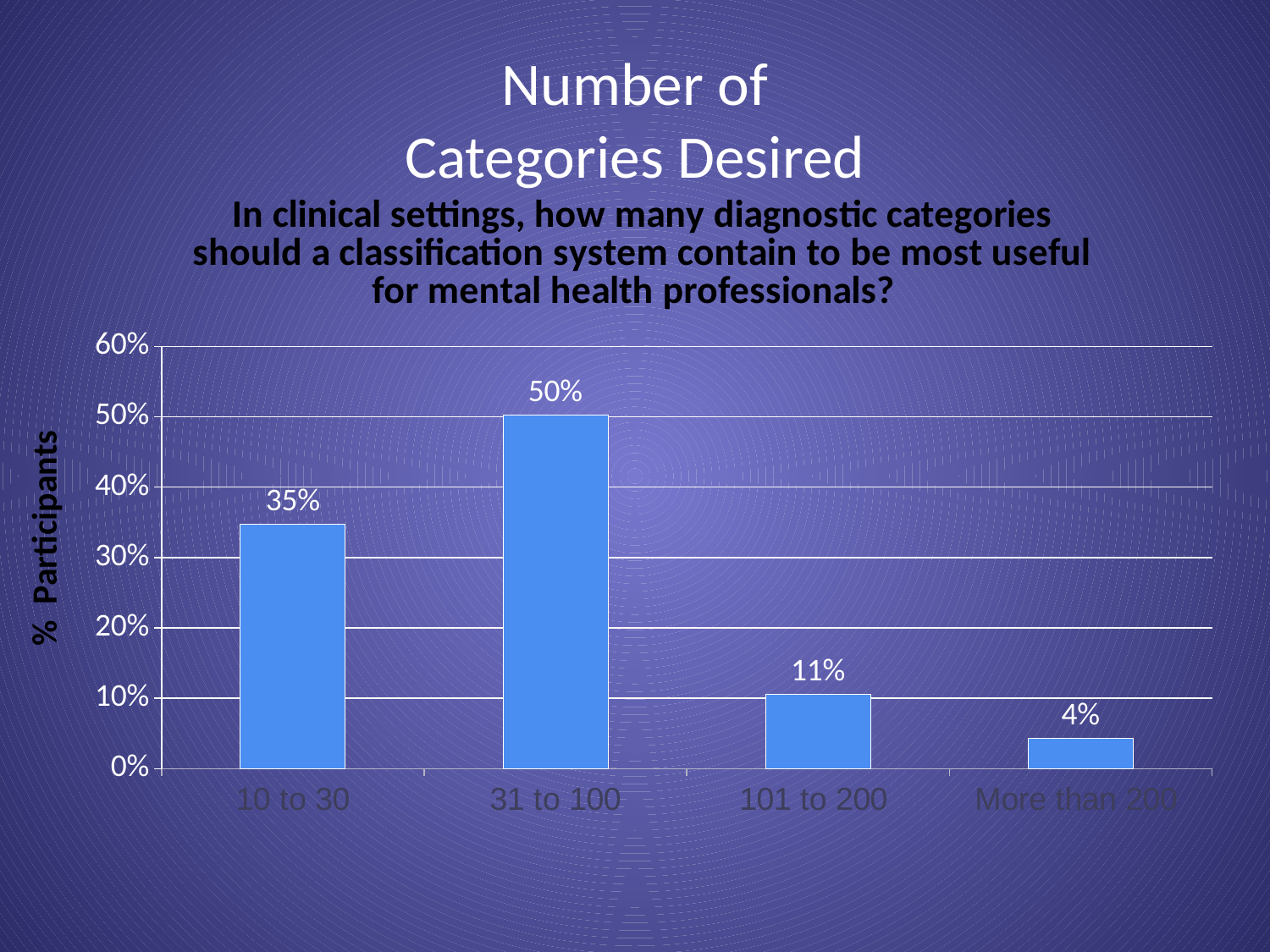
What percentage of participants chose 31 to 100 categories? 50% What is the difference in percentage points between the 101 to 200 and More than 200 bars? 7% Is the value for 101 to 200 greater or less than 20%? less Which category range received the lowest percentage of participants? More than 200 What is the label of the y axis? % Participants What kind of chart is shown on the slide? bar chart What percentage of participants chose More than 200 categories? 4% What is the difference in percentage points between the 31 to 100 and 10 to 30 bars? 15% What percentage of participants chose 10 to 30 categories? 35% Which has a larger percentage of participants, 10 to 30 or 101 to 200? 10 to 30 Which category range received the highest percentage of participants? 31 to 100 How many category ranges are shown on the x axis? 4